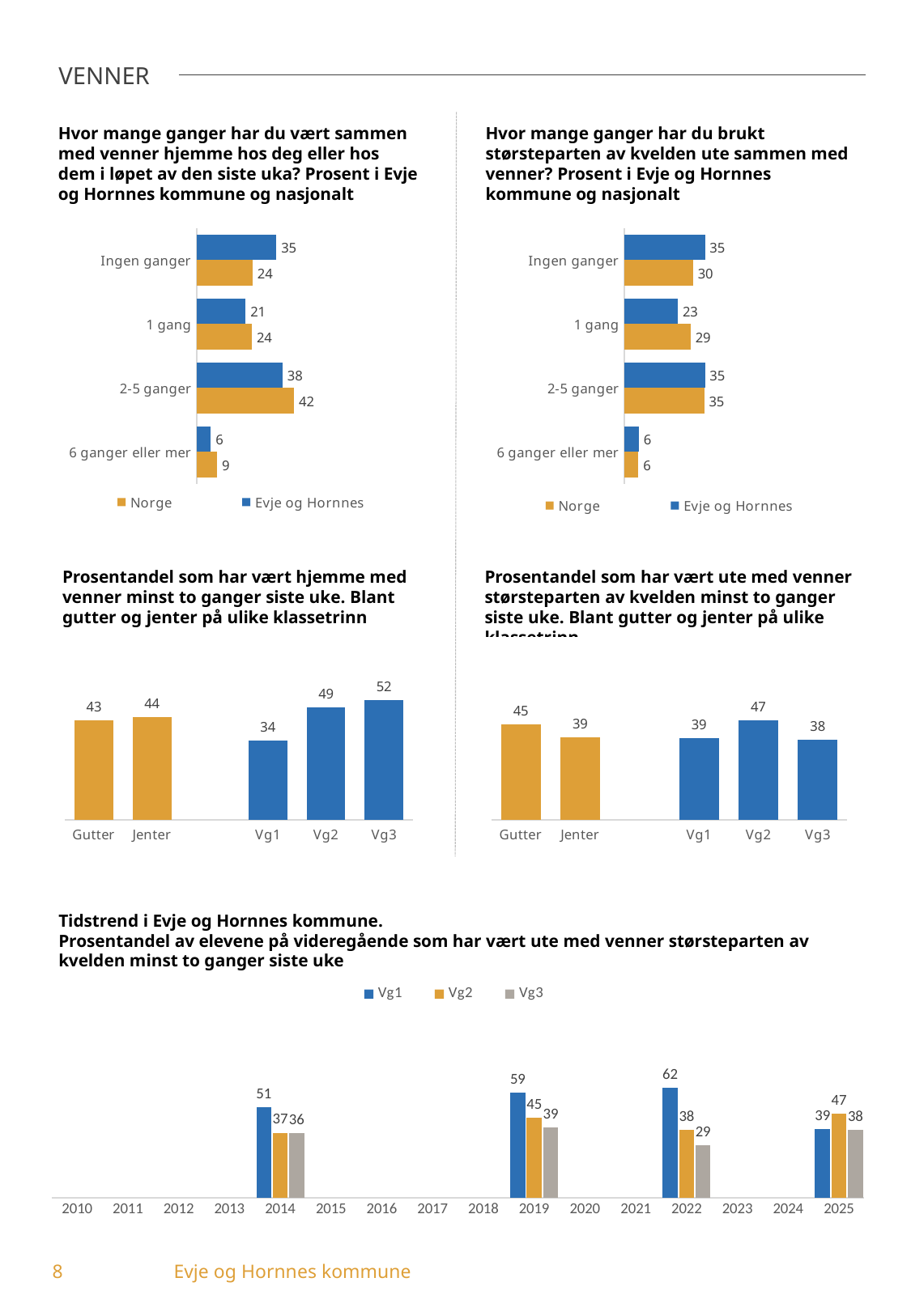
In the top-left chart (venner hjemme), what is the difference between Norge and Evje og Hornnes for '6 ganger eller mer'? 3 In the middle-left chart (hjemme med venner minst to ganger), what is the value for Vg1? 34 In the top-right chart (ute sammen med venner), what is the value for Norge for '1 gang'? 29 In the middle-right chart (ute med venner minst to ganger), which category has the highest value? Vg2 In the top-right chart (ute sammen med venner), how many series does the legend list? 2 In the top-left chart (venner hjemme), what is the value for Norge for 'Ingen ganger'? 24 In the top-left chart (venner hjemme), what is the value for Evje og Hornnes for '2-5 ganger'? 38 In the middle-left chart (hjemme med venner minst to ganger), which category has the highest value? Vg3 In the bottom chart (Tidstrend), what is the value for Vg1 in 2022? 62 In the top-right chart (ute sammen med venner), which is larger for 'Ingen ganger': Norge or Evje og Hornnes? Evje og Hornnes In the middle-right chart (ute med venner minst to ganger), what is the difference between Gutter and Jenter? 6 In the bottom chart (Tidstrend), what kind of chart is it? Bar chart